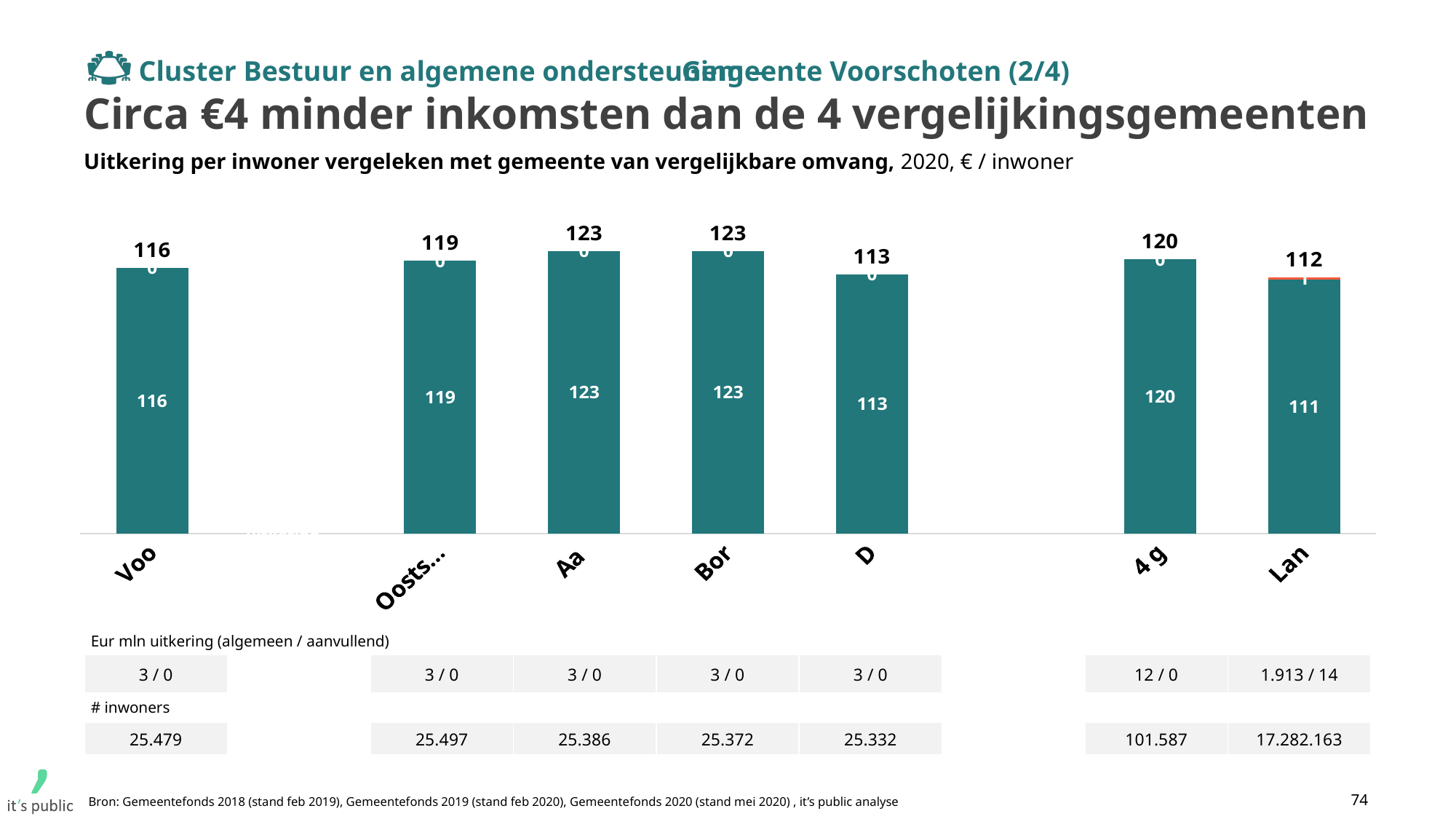
What is the difference between the total for Aa and the total for Voo? 7 How many bars are plotted in the chart? 7 What is the difference between the total for 4 g and the total for D? 7 Which is larger, the total for Oosts... or the total for D? Oosts... What is the value of the teal segment in the bar for Lan? 111 What kind of chart is shown on the slide? bar chart What is the total value shown above the bar for Voo? 116 What is the total of the stacked bar for Lan? 112 What is the total value shown above the bar for D? 113 What is the total value shown above the bar for 4 g? 120 What unit is stated in the chart subtitle for the values? € / inwoner Which category has the lowest total value? Lan